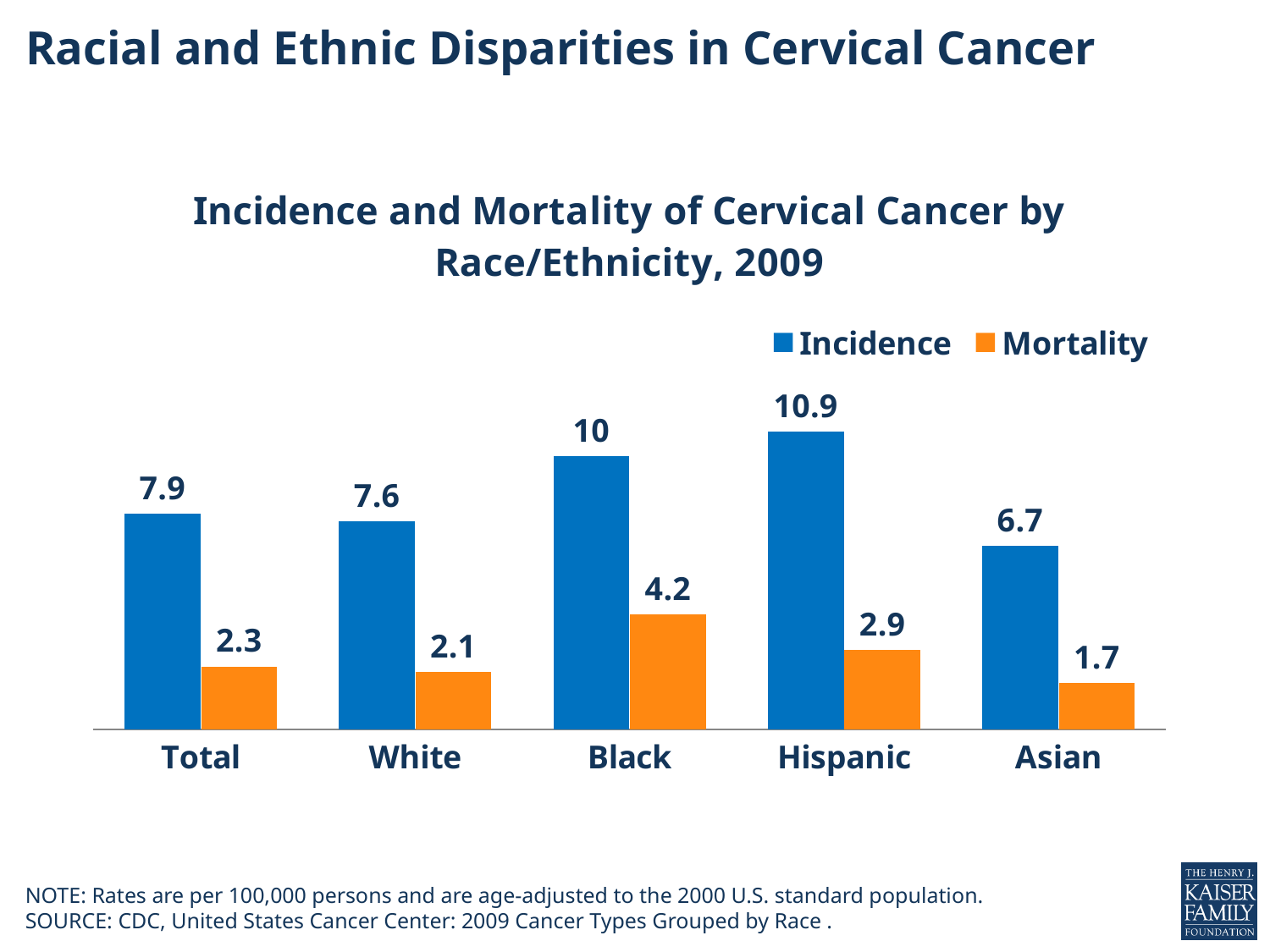
What is the Mortality value for White? 2.1 What is the difference between the Incidence and Mortality values for Black? 5.8 What is the Incidence value for Hispanic? 10.9 Which is larger, the Mortality value for Hispanic or the Mortality value for Total? Hispanic Which category has the lowest Mortality value? Asian What is the Mortality value for Black? 4.2 How many series does the legend list? 2 What is the title of the chart? Incidence and Mortality of Cervical Cancer by Race/Ethnicity, 2009 How many categories are shown on the x axis? 5 What is the Incidence value for Asian? 6.7 What kind of chart is shown on the slide? Bar chart Which category has the highest Incidence value? Hispanic